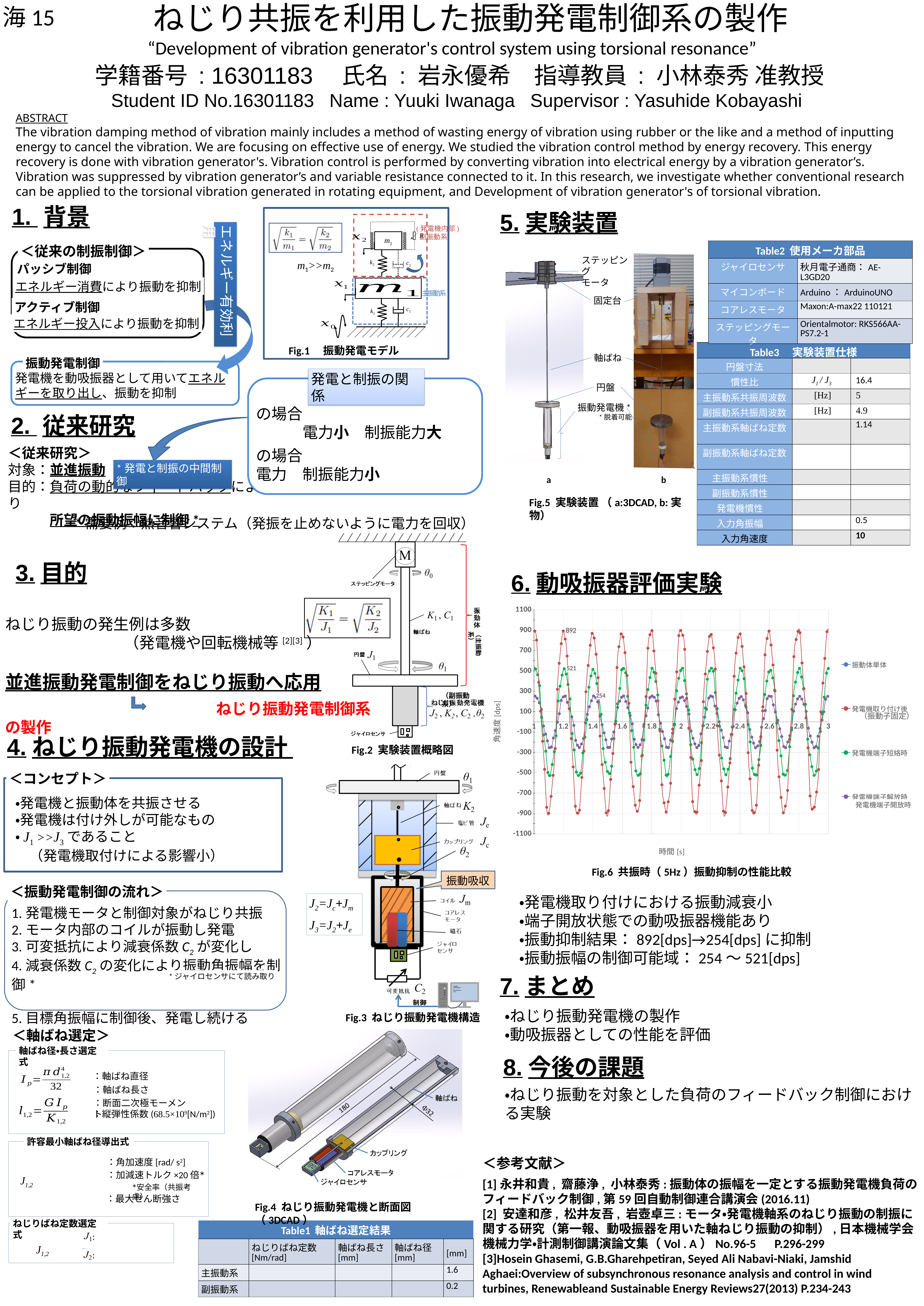
In Fig.6, what is the difference between the data labels 892 and 254? 638 In Fig.6, what is the difference between the data labels 521 and 254? 267 In Fig.6, which series has the larger amplitude, 振動体単体 or 発電機端子開放時? 振動体単体 In Fig.6, is the peak value of the 振動体単体 series greater or less than 700? greater In Fig.6, what is the largest data label printed on the chart? 892 In Fig.6, is the peak value of the 発電機端子開放時 series greater or less than 300? less What is the x-axis label of the chart in Fig.6? 時間 [s] What kind of chart is Fig.6 共振時（5Hz）振動抑制の性能比較? line chart How many series does the legend of Fig.6 list? 4 What is the y-axis label of the chart in Fig.6? 角速度 [dps] In Fig.6, which series has the smallest amplitude? 発電機端子開放時 In Fig.6, what is the smallest data label printed on the chart? 254